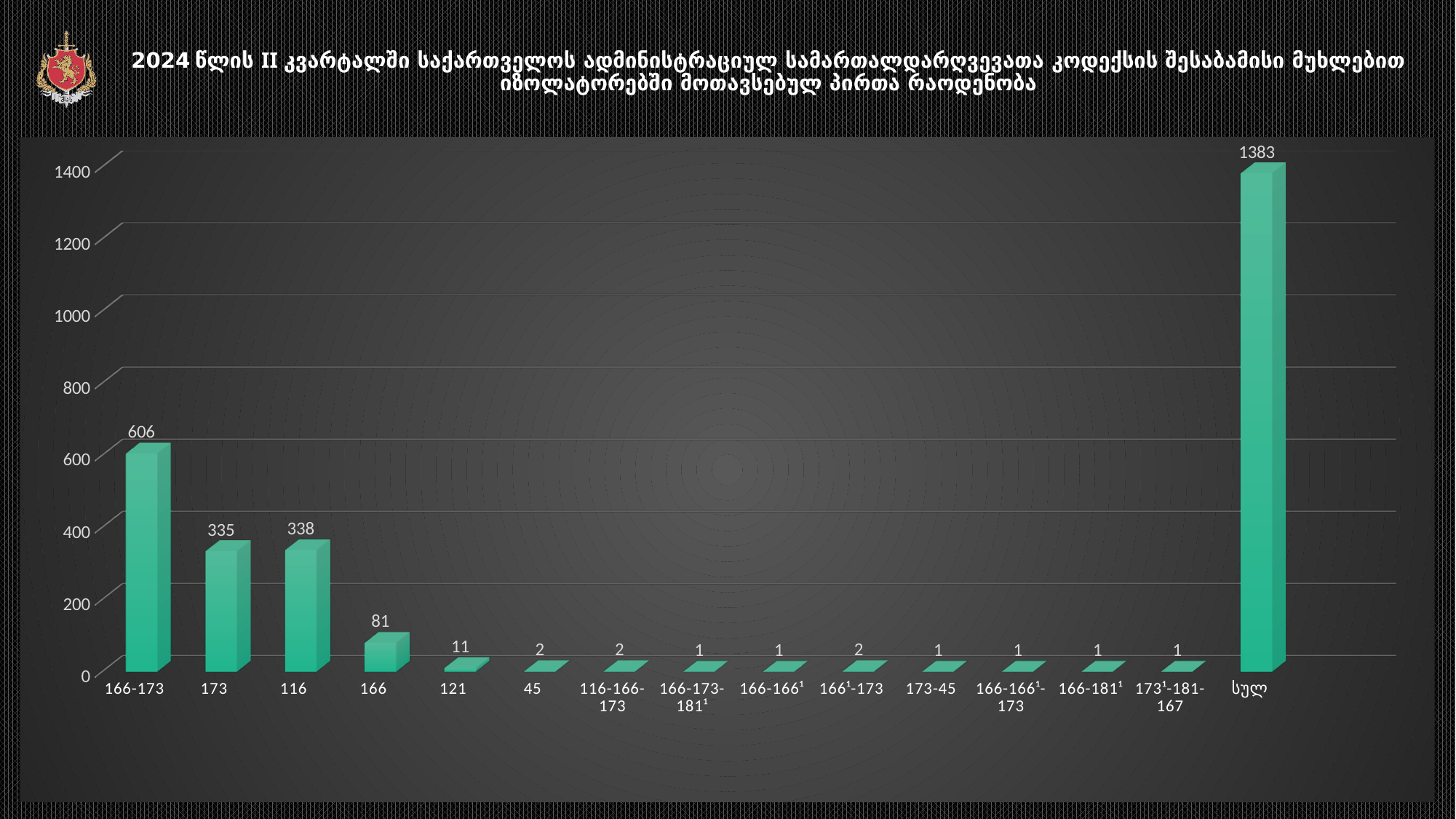
Which category has the highest value? სულ Is the value for 166-173 greater or less than 400? greater What is the difference between the values for 166-173 and 173? 271 What is the value for the category 116? 338 What is the value for the category 166-173? 606 What kind of chart is shown on the slide? bar chart How many categories are shown on the x axis? 15 What is the value for the category სულ? 1383 Which is larger, the value for 116 or the value for 173? 116 What is the value for the category 121? 11 What is the value for the category 173? 335 What is the value for the category 166? 81